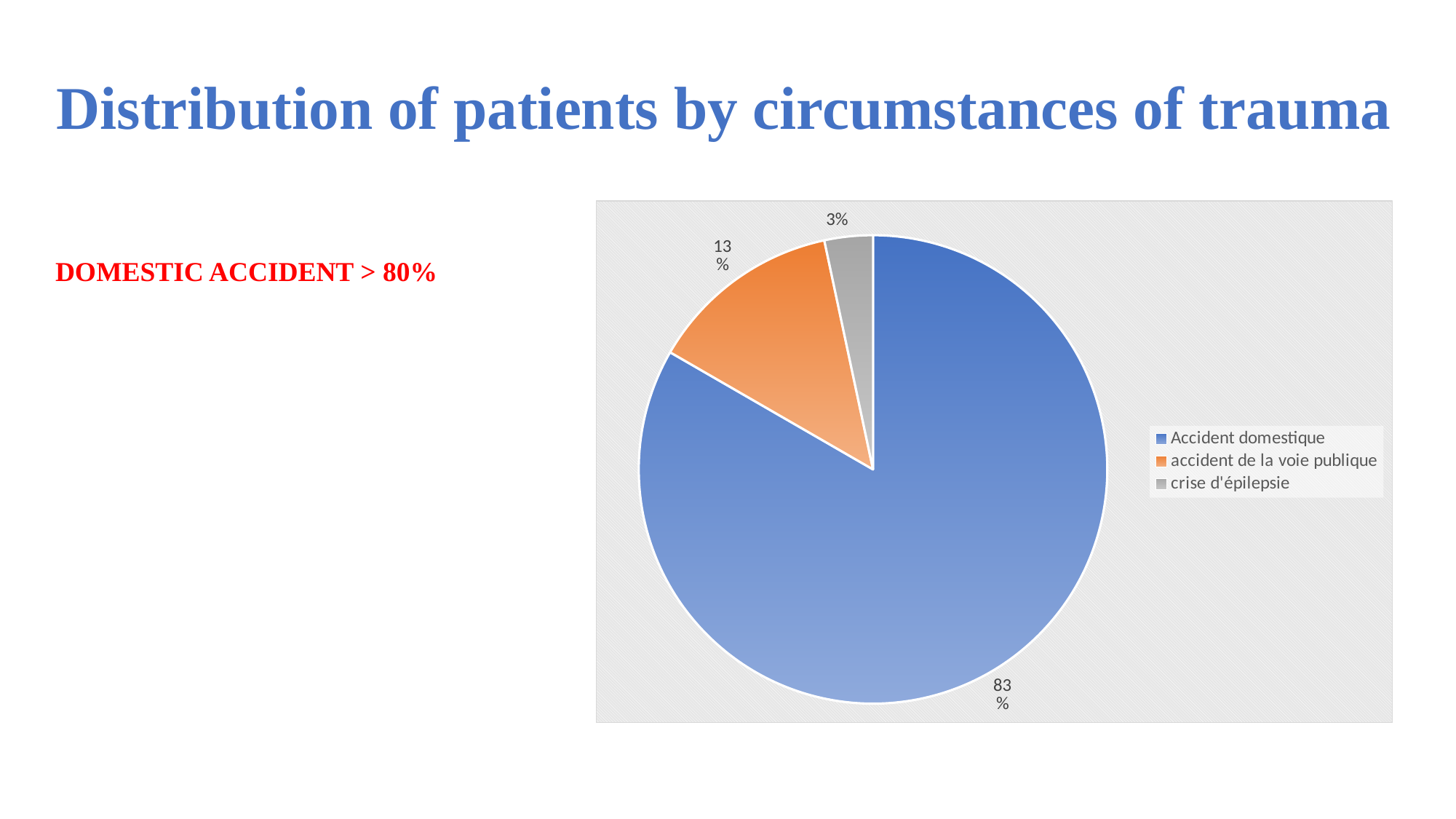
What percentage of patients had an 'Accident domestique'? 83% What is the difference in percentage points between 'accident de la voie publique' and 'crise d'épilepsie'? 10 What is the title of the slide containing the chart? Distribution of patients by circumstances of trauma Which circumstance of trauma accounts for the smallest share of patients? crise d'épilepsie Which is larger: the share for 'accident de la voie publique' or for 'crise d'épilepsie'? accident de la voie publique Which circumstance of trauma accounts for the largest share of patients? Accident domestique What colour is the slice for 'accident de la voie publique'? orange How many categories does the pie chart show? 3 What is the difference in percentage points between 'Accident domestique' and 'accident de la voie publique'? 70 What type of chart is shown on the slide? pie chart What percentage of patients had an 'accident de la voie publique'? 13% What percentage of patients had a 'crise d'épilepsie'? 3%